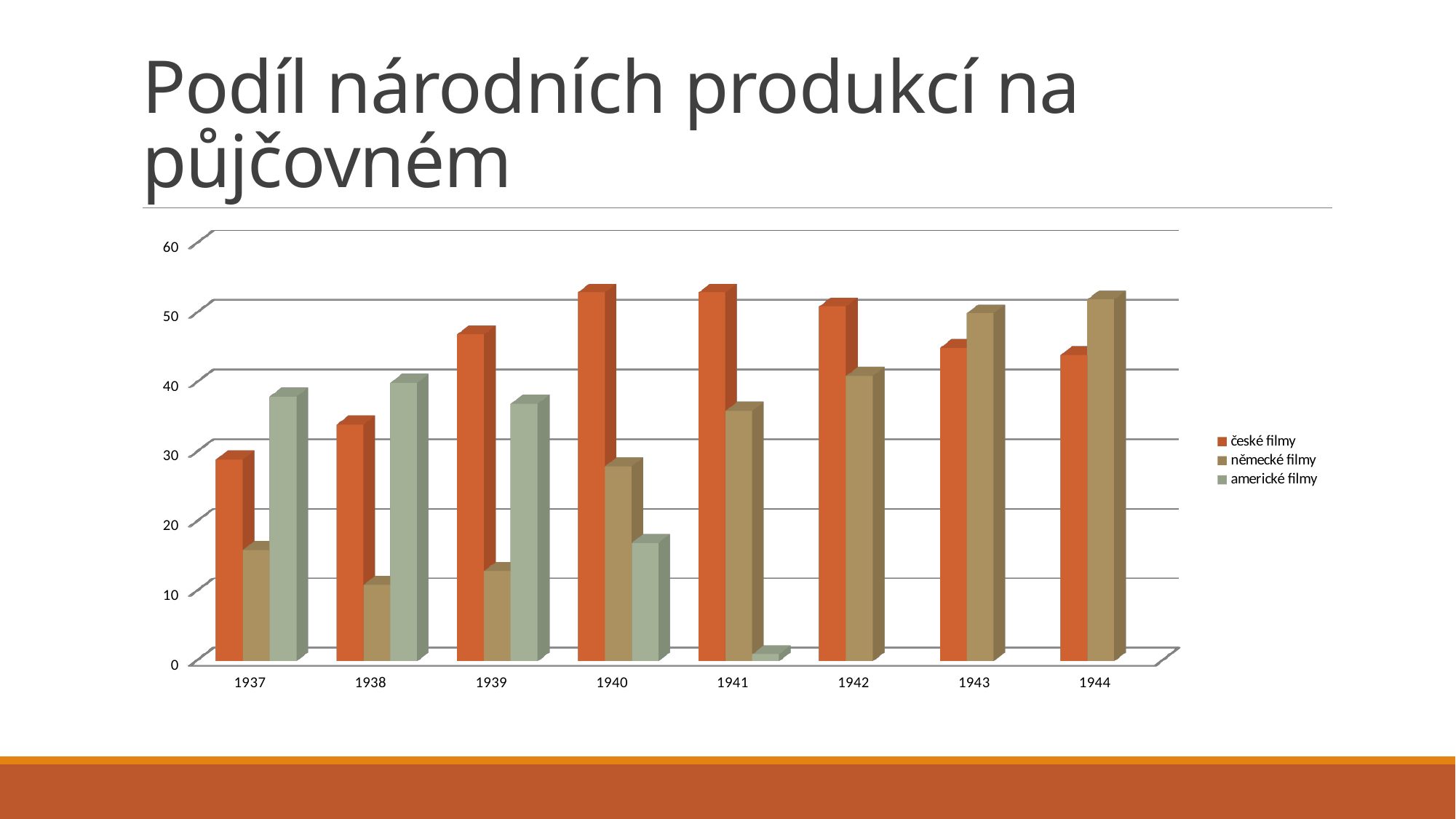
In 1937, which is larger: české filmy or americké filmy? americké filmy Is the value for německé filmy in 1938 greater or less than 20? less Is the value for německé filmy in 1944 greater or less than 40? greater Do the values for německé filmy generally rise or fall from 1938 to 1944? rise Is the value for české filmy in 1940 greater or less than 50? greater What kind of chart is shown on the slide? bar chart In which year is the value for americké filmy lowest? 1941 In 1940, which is larger: německé filmy or americké filmy? německé filmy How many series does the chart's legend list? 3 How many years are shown on the x axis of the chart? 8 In which year is the value for české filmy lowest? 1937